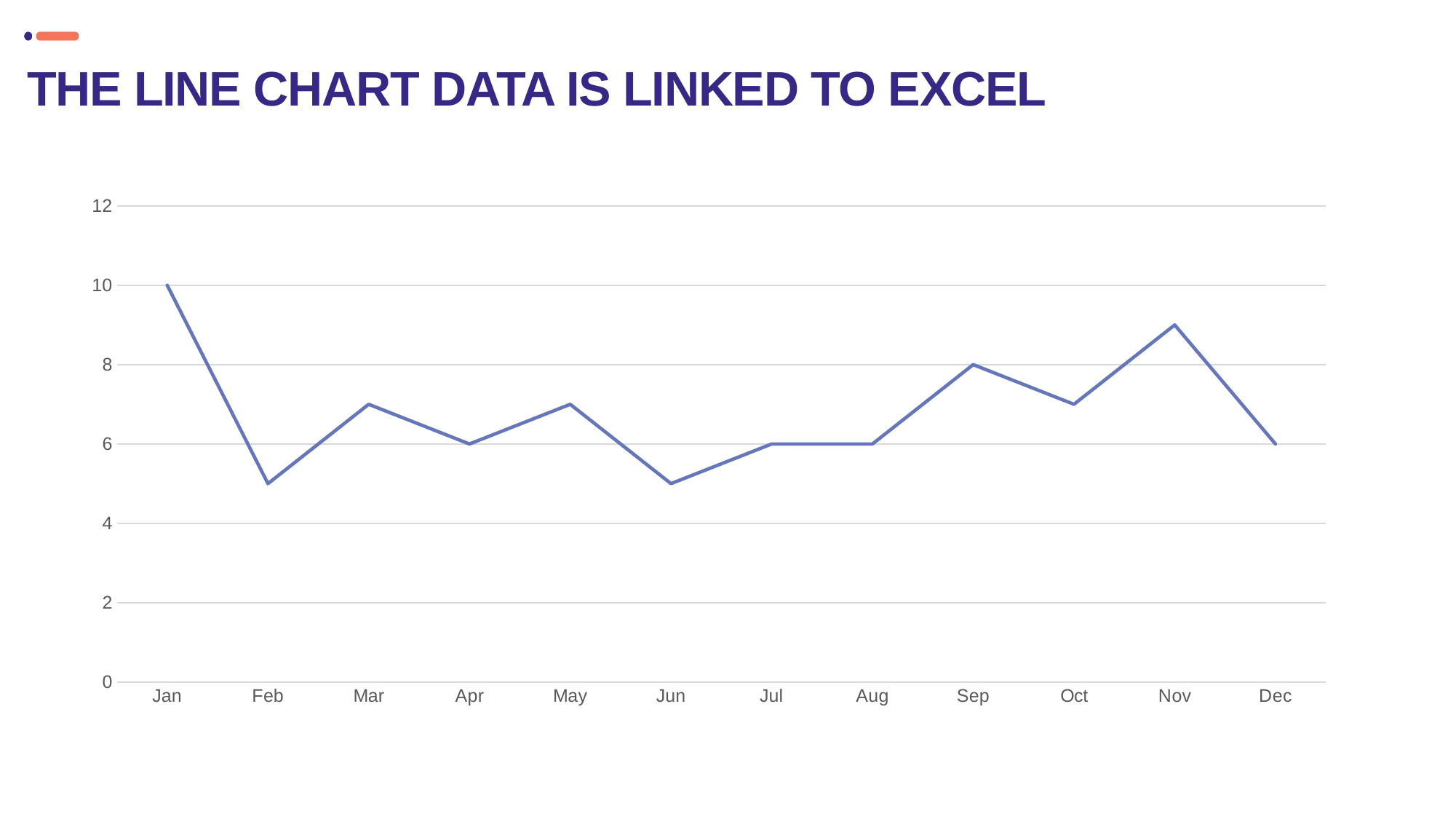
Does the line rise or fall from Jan to Feb? fall What kind of chart is shown on the slide? line chart Is the value for Nov greater or less than 8? greater What is the value for Sep? 8 What is the difference between the values for Jan and Dec? 4 Which month has the highest value? Jan What is the title of the slide? THE LINE CHART DATA IS LINKED TO EXCEL What is the value for Dec? 6 Is the value for Feb greater or less than 6? less How many months are plotted along the x axis? 12 Which is larger, the value for Jan or the value for Dec? Jan What is the value for Jan? 10